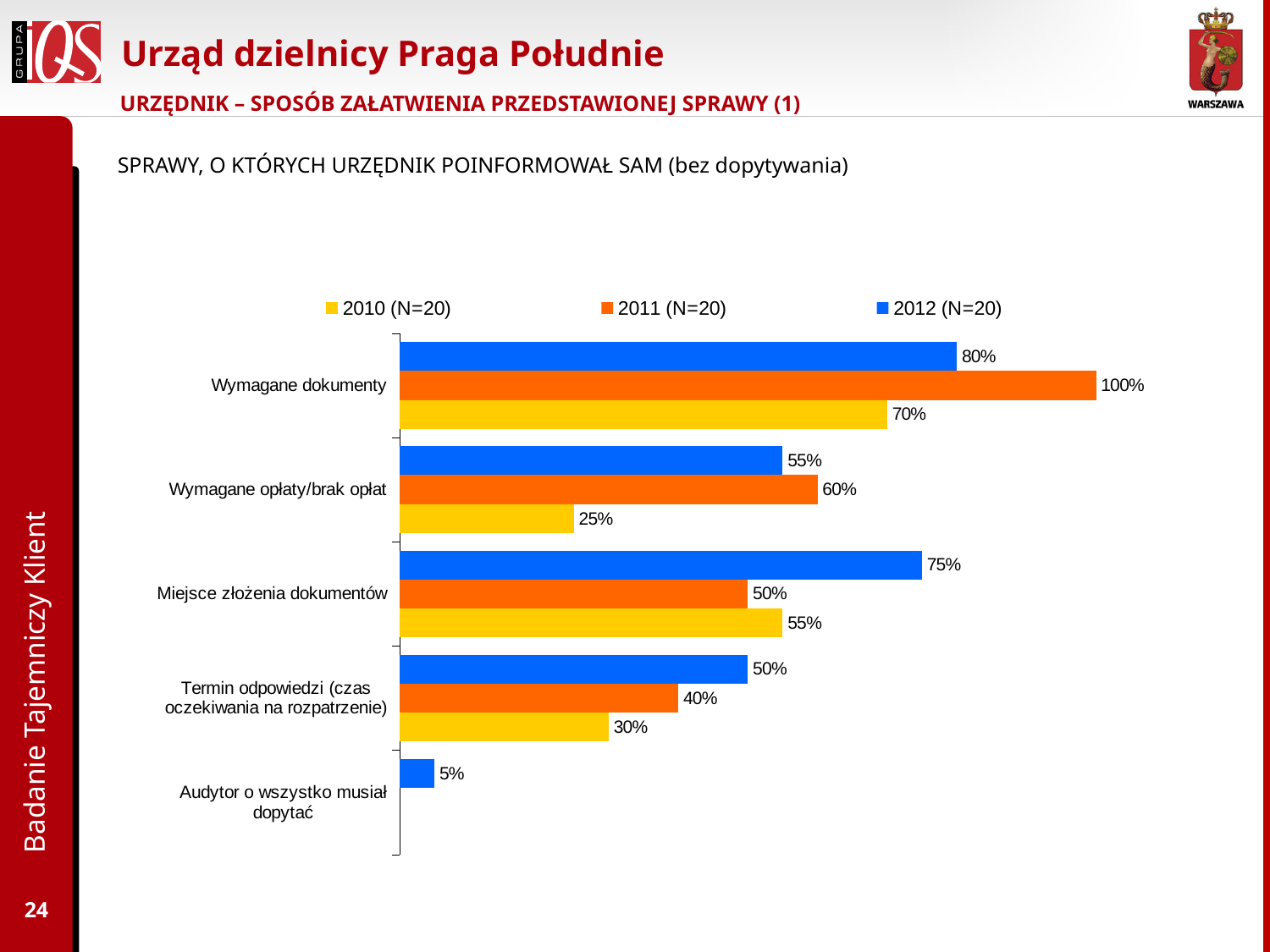
What is the value for Wymagane dokumenty in the 2011 (N=20) series? 100% What is the value for Wymagane opłaty/brak opłat in the 2010 (N=20) series? 25% What is the difference between the 2011 (N=20) and 2010 (N=20) values for Wymagane dokumenty? 30% What is the value for Miejsce złożenia dokumentów in the 2012 (N=20) series? 75% Which is larger for Miejsce złożenia dokumentów: the 2012 (N=20) value or the 2011 (N=20) value? 2012 (N=20) Which category has the lowest value in the 2010 (N=20) series among those with a bar shown? Wymagane opłaty/brak opłat Which category has the highest value in the 2012 (N=20) series? Wymagane dokumenty Which colour represents the 2011 (N=20) series? Orange What is the value for Audytor o wszystko musiał dopytać in the 2012 (N=20) series? 5% How many series does the legend list? 3 What kind of chart is shown on the slide? Bar chart How many categories are shown on the chart? 5